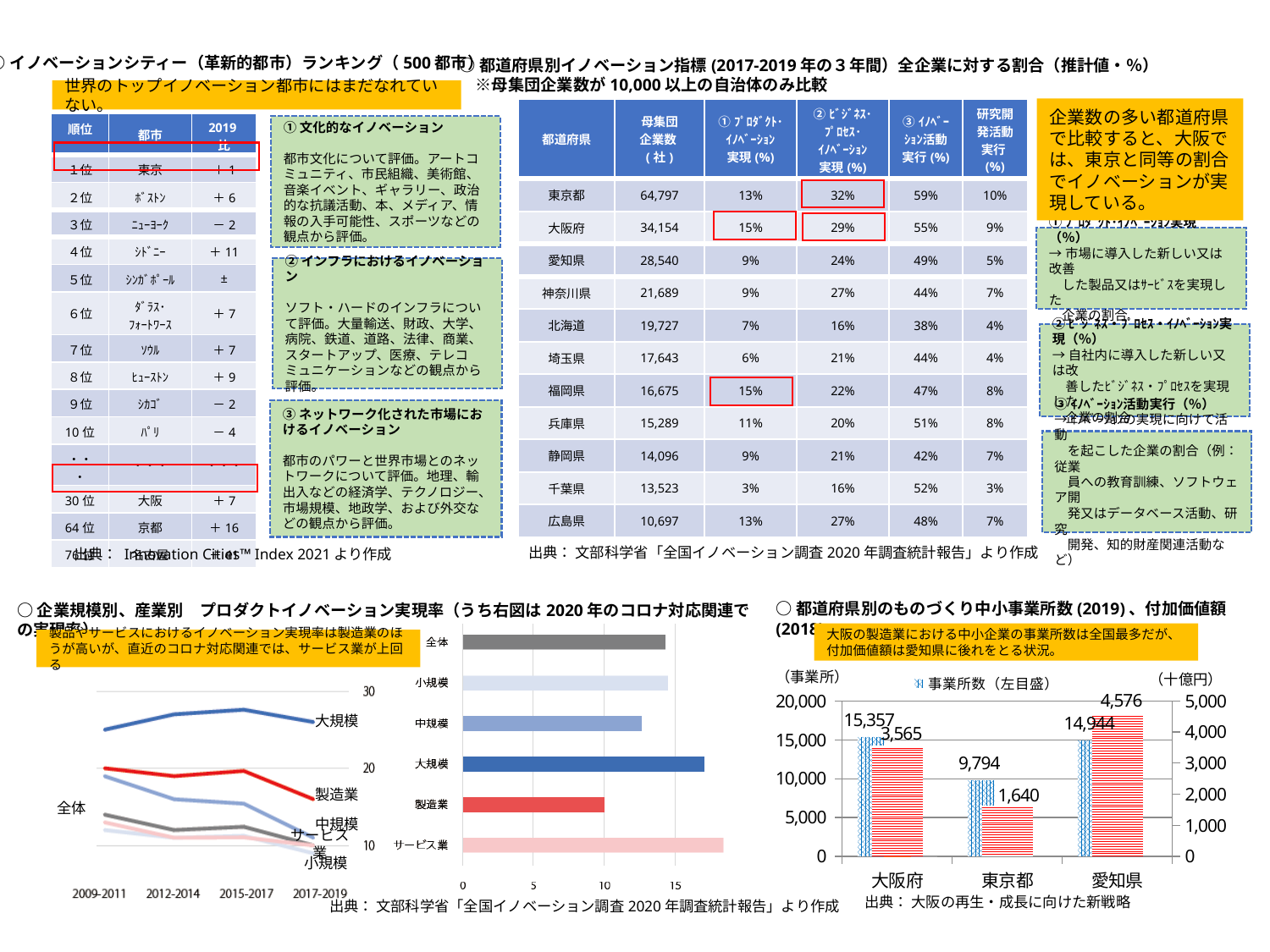
In the bottom-right chart (都道府県別のものづくり中小事業所数), how many prefectures are shown on the x axis? 3 In the bottom-middle horizontal bar chart (プロダクトイノベーション実現率), which category has the lowest value? 製造業 In the bottom-right chart (都道府県別のものづくり中小事業所数), what is the 付加価値額 value for 愛知県? 4,576 In the bottom-middle horizontal bar chart (プロダクトイノベーション実現率), is the value for 製造業 greater or less than 15? less In the bottom-right chart (都道府県別のものづくり中小事業所数), which prefecture has the highest 事業所数? 大阪府 In the bottom-right chart (都道府県別のものづくり中小事業所数), what is the number of 事業所数 for 大阪府? 15,357 What kind of chart is the bottom-left chart showing 大規模, 製造業, 全体, 中規模, サービス業 and 小規模 over 2009-2011 to 2017-2019? line chart In the bottom-left line chart, is the value for 大規模 in 2017-2019 greater or less than 20? greater In the bottom-right chart (都道府県別のものづくり中小事業所数), what is the difference in 事業所数 between 大阪府 and 愛知県? 413 In the bottom-right chart (都道府県別のものづくり中小事業所数), what is the number of 事業所数 for 東京都? 9,794 In the bottom-right chart (都道府県別のものづくり中小事業所数), which prefecture has the lowest 付加価値額? 東京都 In the bottom-middle horizontal bar chart (プロダクトイノベーション実現率), how many categories are shown? 6